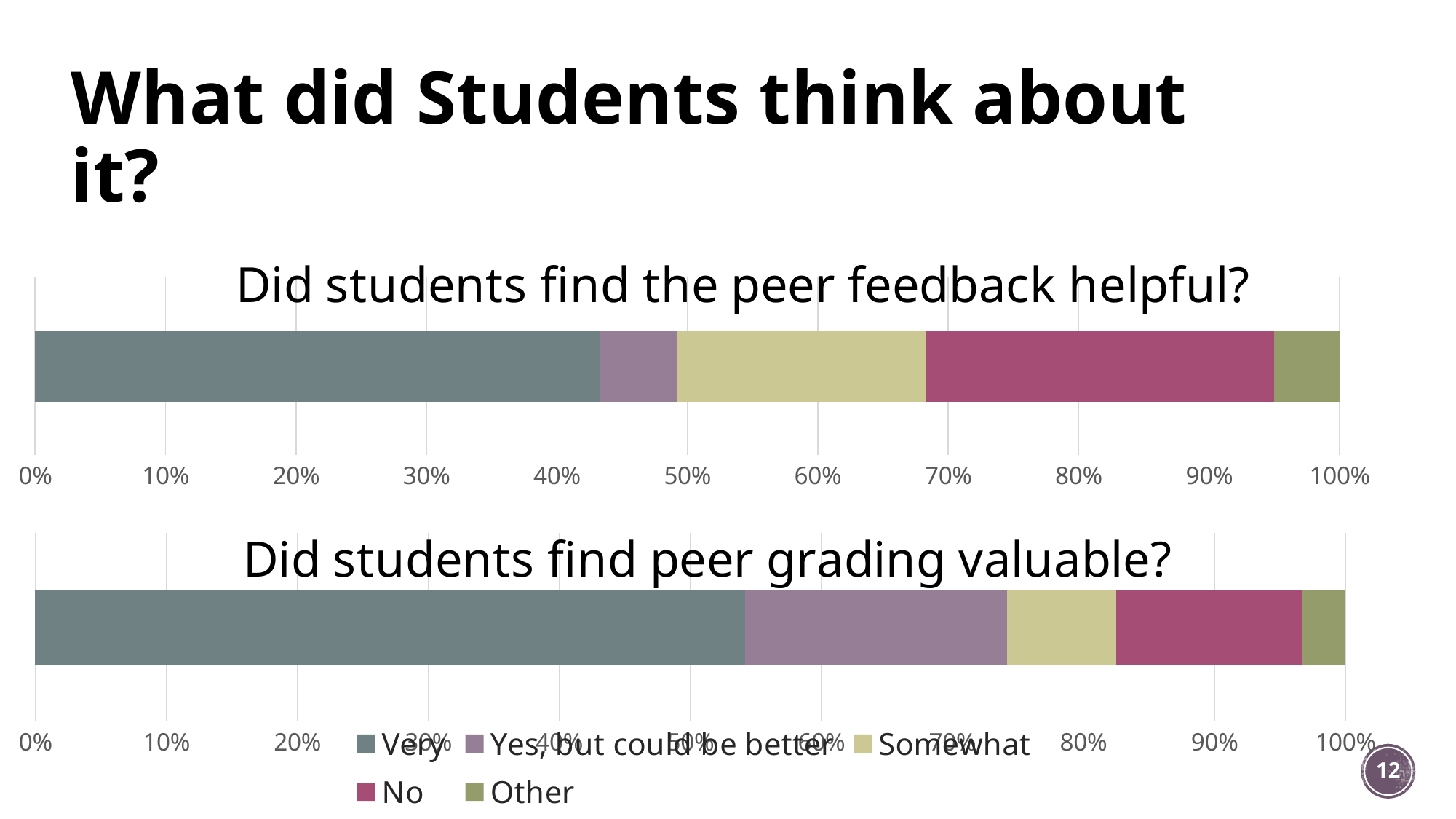
In the chart "Did students find peer grading valuable?", is the share for No greater or less than 20%? less In the chart "Did students find peer grading valuable?", is the share for Very greater or less than 50%? greater Which chart has the larger share for Yes, but could be better: "Did students find the peer feedback helpful?" or "Did students find peer grading valuable?"? Did students find peer grading valuable? What is the title of the upper chart on the slide? Did students find the peer feedback helpful? What kind of chart is used for "Did students find the peer feedback helpful?"? Stacked bar chart In the chart "Did students find the peer feedback helpful?", which response category has the largest share? Very In the chart "Did students find the peer feedback helpful?", is the share for Very greater or less than 40%? greater In the chart "Did students find peer grading valuable?", which is larger: the share for Yes, but could be better or the share for Somewhat? Yes, but could be better In the chart "Did students find the peer feedback helpful?", which is larger: the share for Very or the share for No? Very In the chart "Did students find peer grading valuable?", which response category has the largest share? Very How many series does the legend list for the charts on this slide? 5 In the chart "Did students find peer grading valuable?", which response category has the smallest share? Other